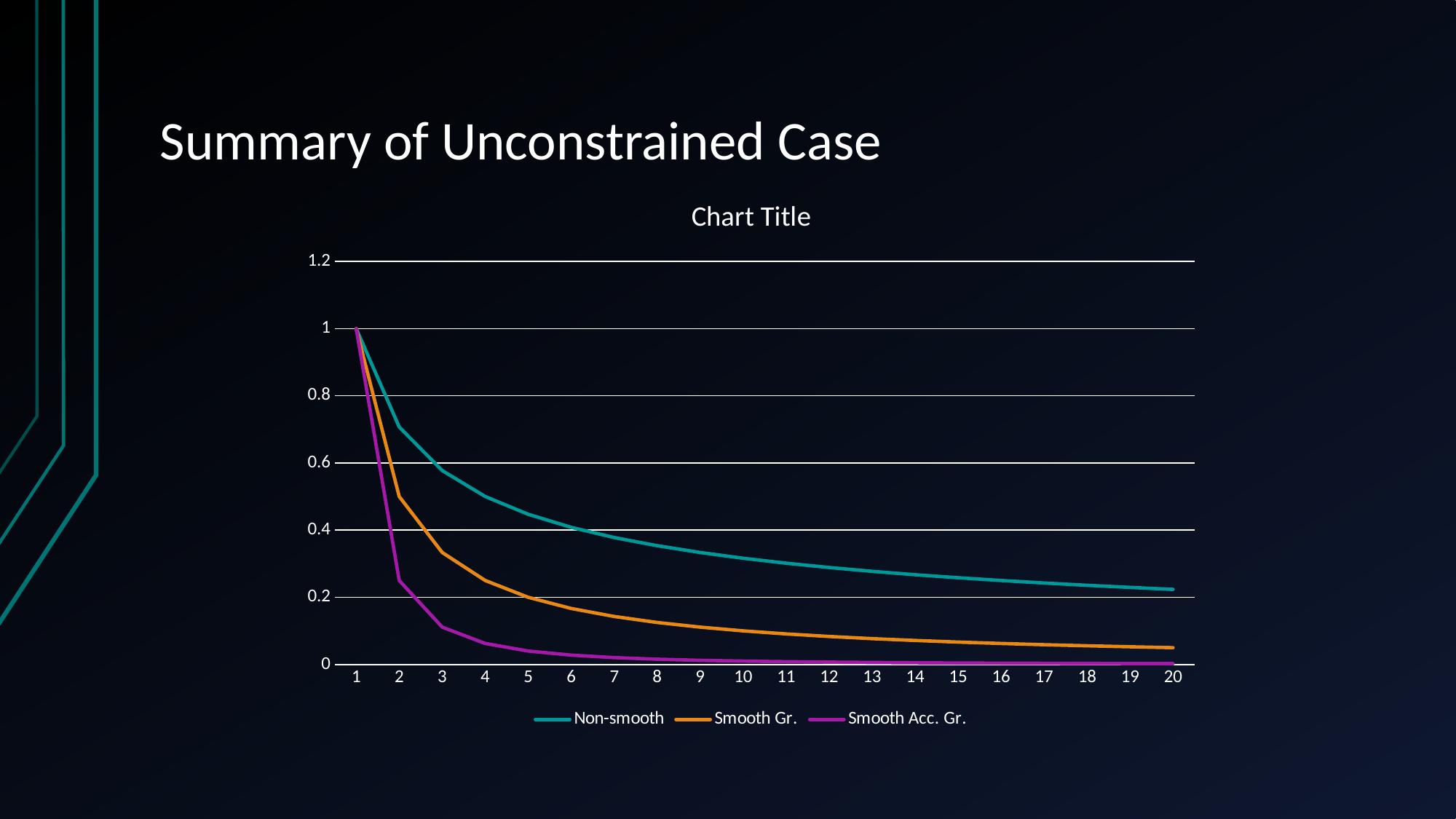
How many points are plotted along the x axis for each series? 20 How many series does the legend list? 3 Is the value of the Smooth Gr. series at x = 10 greater or less than 0.2? less What is the title shown above the chart? Chart Title Which series has the highest value at x = 10? Non-smooth What is the value of the Non-smooth series at x = 1? 1 Which series has the lowest value at x = 5? Smooth Acc. Gr. Is the value of the Smooth Acc. Gr. series at x = 2 greater or less than 0.4? less At x = 3, which series has the larger value, Smooth Gr. or Non-smooth? Non-smooth What kind of chart is shown on the slide? line chart Do the values of the Non-smooth series rise or fall as x increases from 1 to 20? fall Is the value of the Non-smooth series at x = 20 greater or less than 0.2? greater